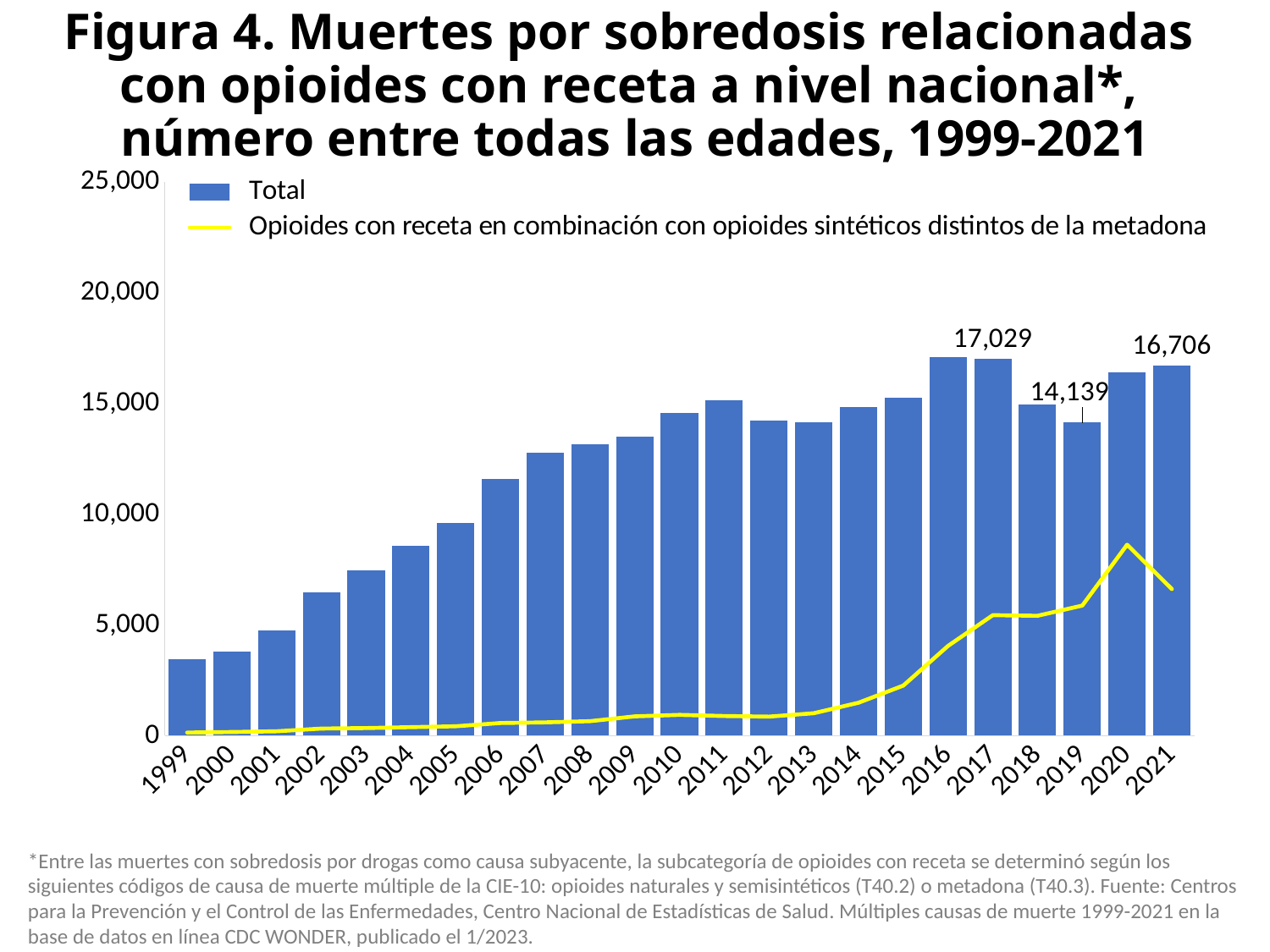
In which year does the yellow line (opioides con receta en combinación con opioides sintéticos distintos de la metadona) reach its peak? 2020 Is the value of the yellow line in 2015 greater or less than 5,000? less Is the Total value for 2005 greater or less than 10,000? less How many series does the legend list? 2 Does the Total series generally rise or fall from 1999 to 2016? rise Is the Total value for 2010 greater or less than 10,000? greater Which is larger, the Total value for 2016 or for 2021? 2016 Which year has the lowest Total bar? 1999 How many years are shown on the x axis? 23 What is the value of the Total bar for 2021? 16,706